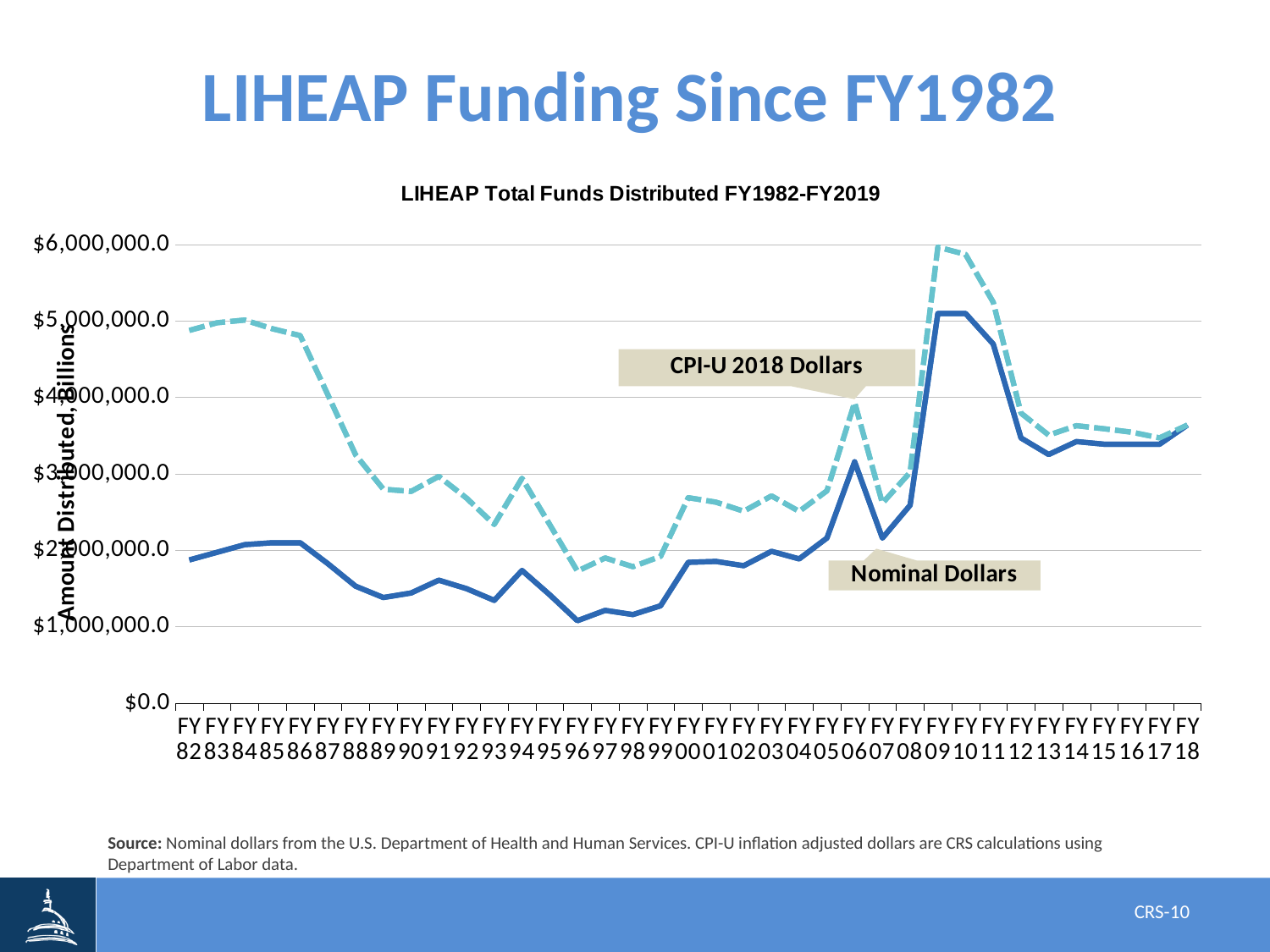
At FY82, which series has the larger value, Nominal Dollars or CPI-U 2018 Dollars? CPI-U 2018 Dollars How many series are plotted on the chart? 2 How many fiscal years are plotted along the x axis? 37 Which series is drawn with a dashed line? CPI-U 2018 Dollars What is the title of the chart? LIHEAP Total Funds Distributed FY1982-FY2019 Is the CPI-U 2018 Dollars value for FY82 greater or less than $4,000,000.0? greater Is the CPI-U 2018 Dollars value for FY06 greater or less than $3,000,000.0? greater Does the CPI-U 2018 Dollars series rise or fall from FY82 to FY96? Fall In which fiscal year is the Nominal Dollars series at its lowest? FY96 Is the Nominal Dollars value for FY96 greater or less than $2,000,000.0? less What kind of chart is shown on the slide? Line chart